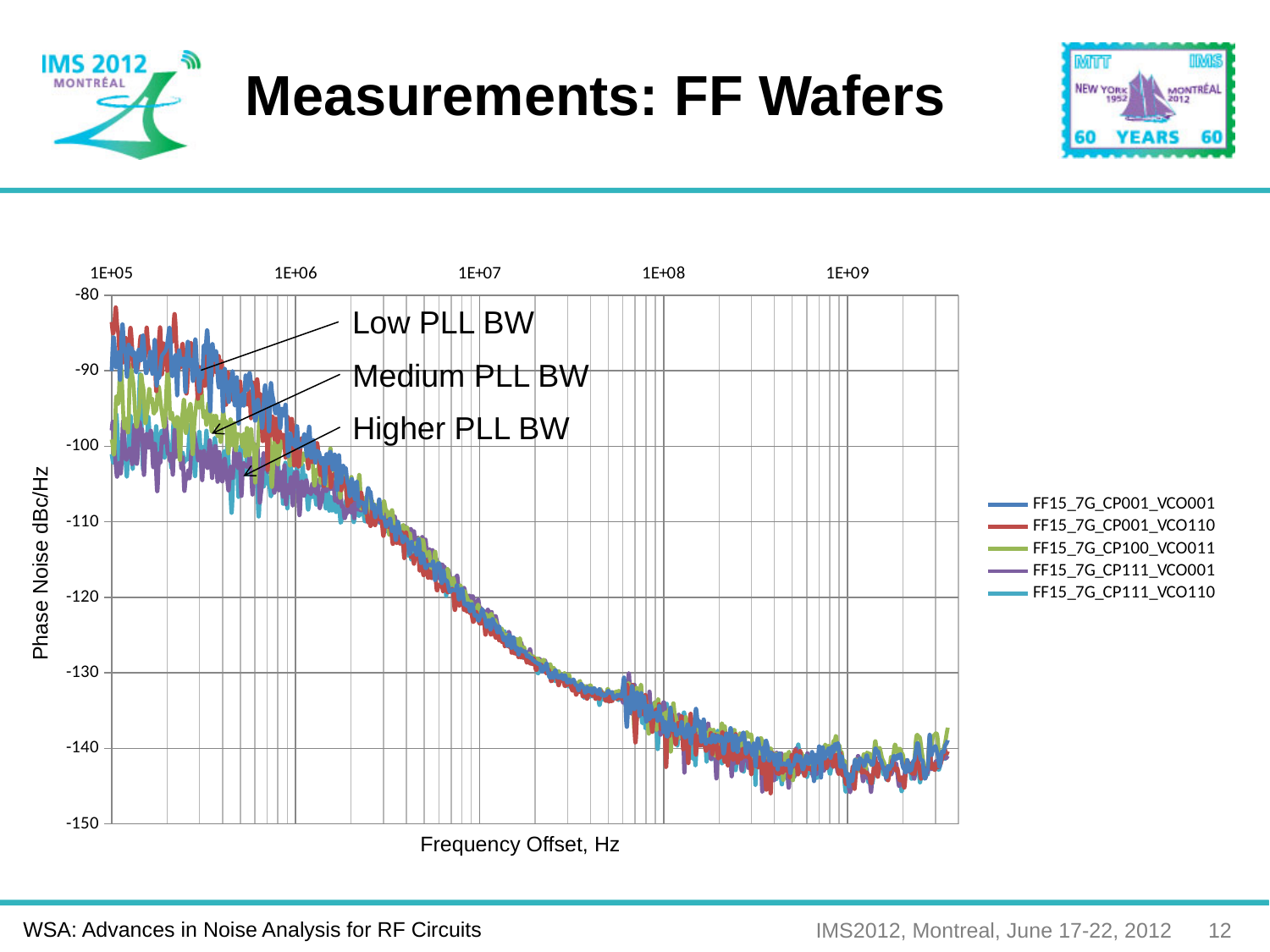
How many labelled tick values are shown on the x axis? 5 Is the value for FF15_7G_CP100_VCO011 at a frequency offset of 1E+07 Hz greater or less than -110? less Is the value for FF15_7G_CP001_VCO001 at a frequency offset of 1E+05 Hz greater or less than -100? greater How many series does the legend list? 5 What is the label of the y axis? Phase Noise dBc/Hz What kind of chart is shown on the slide? line chart Do the phase noise values rise or fall as the frequency offset increases along the x axis? fall Is the value for FF15_7G_CP001_VCO110 at a frequency offset of 1E+09 Hz greater or less than -130? less At a frequency offset of 1E+05 Hz, which series has the higher phase noise value, FF15_7G_CP001_VCO001 or FF15_7G_CP111_VCO001? FF15_7G_CP001_VCO001 Which annotation on the chart points to the curves with the highest phase noise at low frequency offsets? Low PLL BW